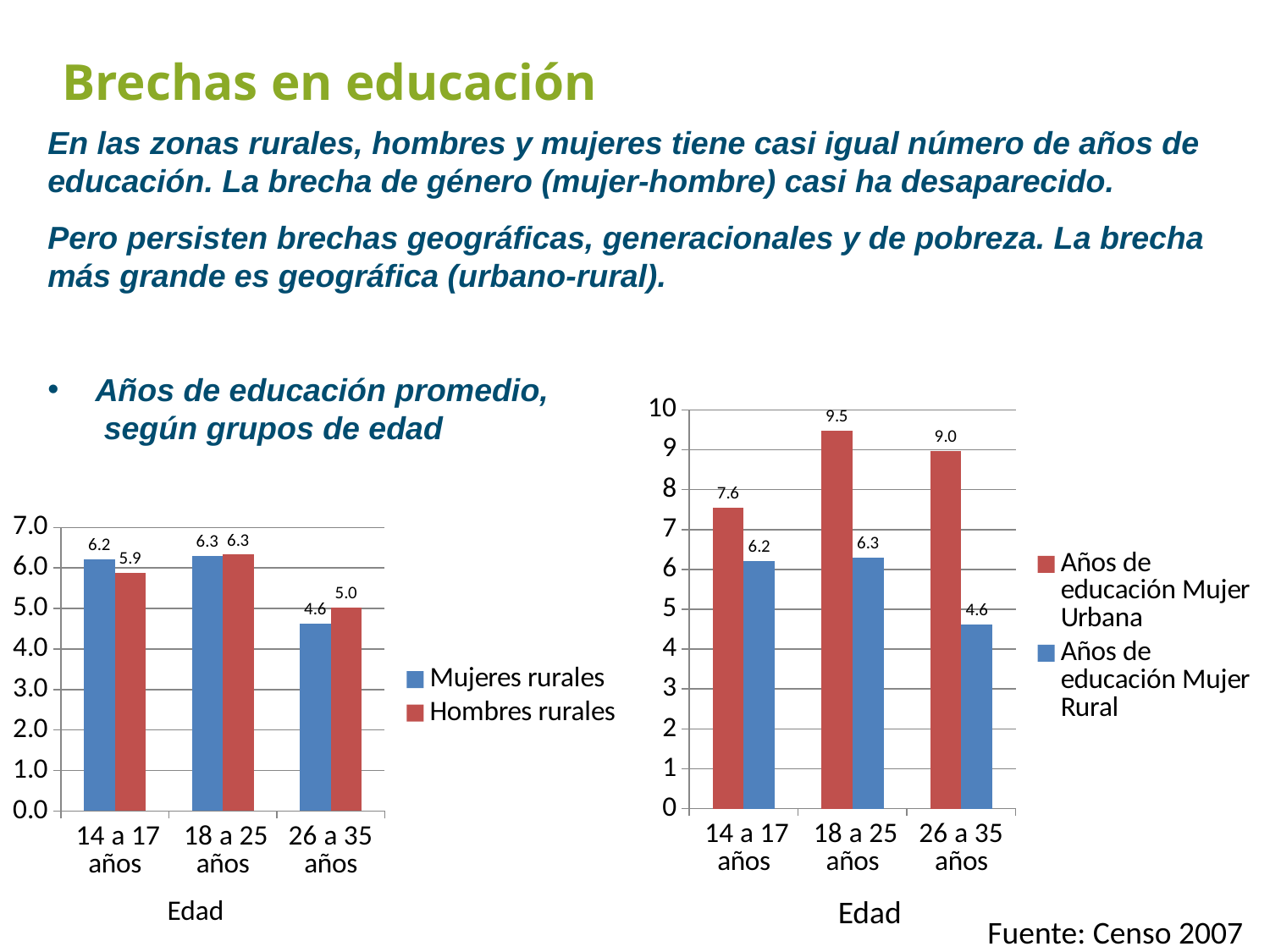
In the right chart, which is larger in the 14 a 17 años group: Mujer Urbana or Mujer Rural? Mujer Urbana In the right chart, which age group has the highest value for Años de educación Mujer Urbana? 18 a 25 años In the left chart, what is the value for Mujeres rurales in the 14 a 17 años group? 6.2 In the right chart, what is the value for Años de educación Mujer Rural in the 26 a 35 años group? 4.6 In the left chart, how many series does the legend list? 2 In the right chart, what is the difference between Mujer Urbana and Mujer Rural in the 26 a 35 años group? 4.4 In the left chart, what is the value for Hombres rurales in the 26 a 35 años group? 5.0 In the right chart, how many age groups are shown on the x axis? 3 In the left chart, what is the difference between Hombres rurales and Mujeres rurales in the 26 a 35 años group? 0.4 In the left chart, which age group has the lowest value for Mujeres rurales? 26 a 35 años What kind of chart is the right chart? Bar chart In the right chart, what is the value for Años de educación Mujer Urbana in the 18 a 25 años group? 9.5